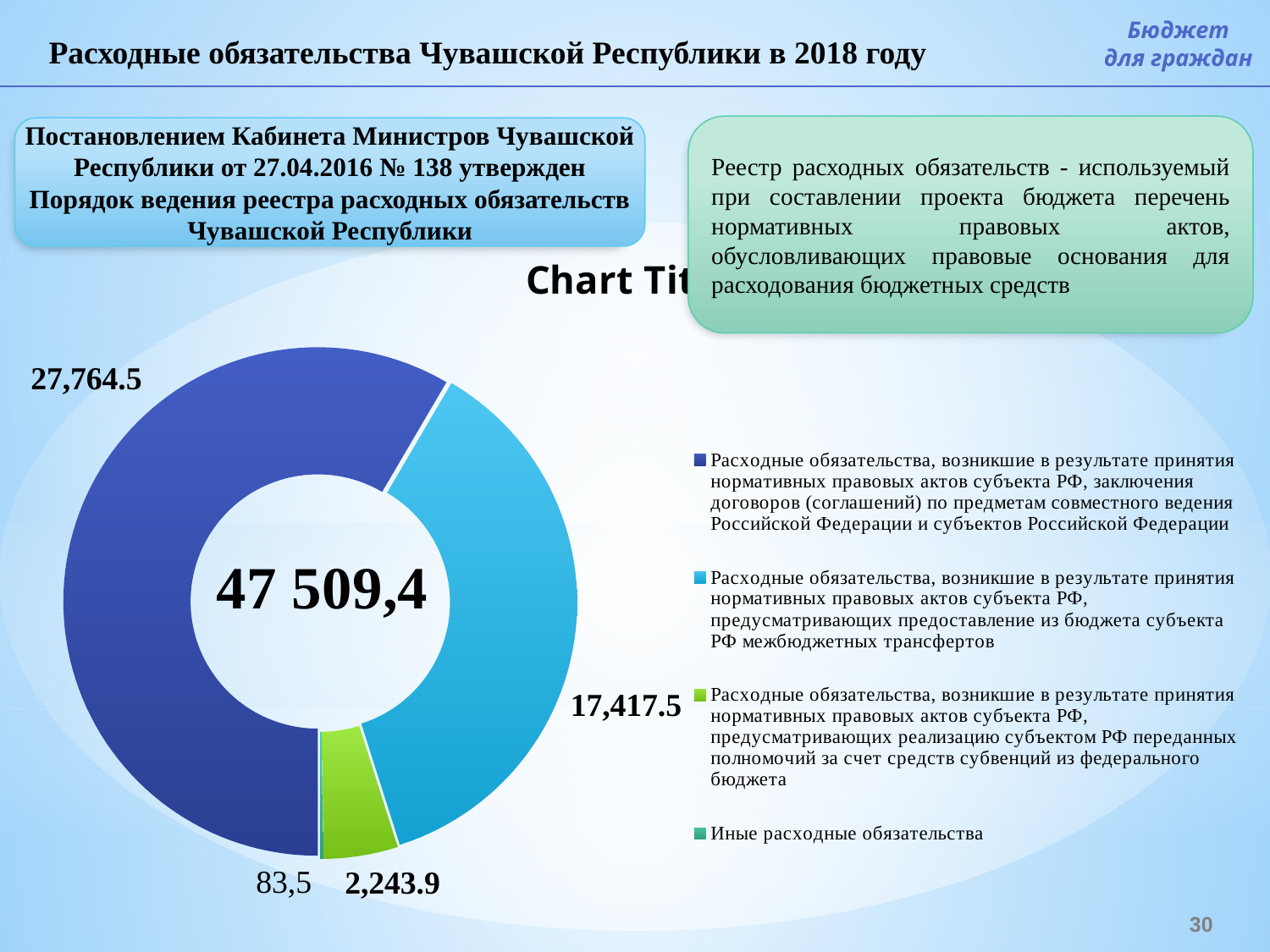
Which is larger: the slice for межбюджетных трансфертов or the slice for субвенций из федерального бюджета? межбюджетных трансфертов (17,417.5) What is the value of the smallest slice in the doughnut chart? 83,5 What is the difference between the dark blue slice (27,764.5) and the light blue slice (17,417.5)? 10,347.0 How many entries does the chart legend list? 4 How many slices does the doughnut chart have? 4 What value is shown for the light blue slice (обязательства, предусматривающие предоставление межбюджетных трансфертов)? 17,417.5 What kind of chart is shown on the slide? doughnut chart What value is shown for the green slice (обязательства за счет средств субвенций из федерального бюджета)? 2,243.9 What is the difference between the light blue slice (17,417.5) and the green slice (2,243.9)? 15,173.6 What total is printed in the centre of the doughnut chart? 47 509,4 What is the value of the largest slice in the doughnut chart? 27,764.5 What value is shown for the slice 'Иные расходные обязательства'? 83,5